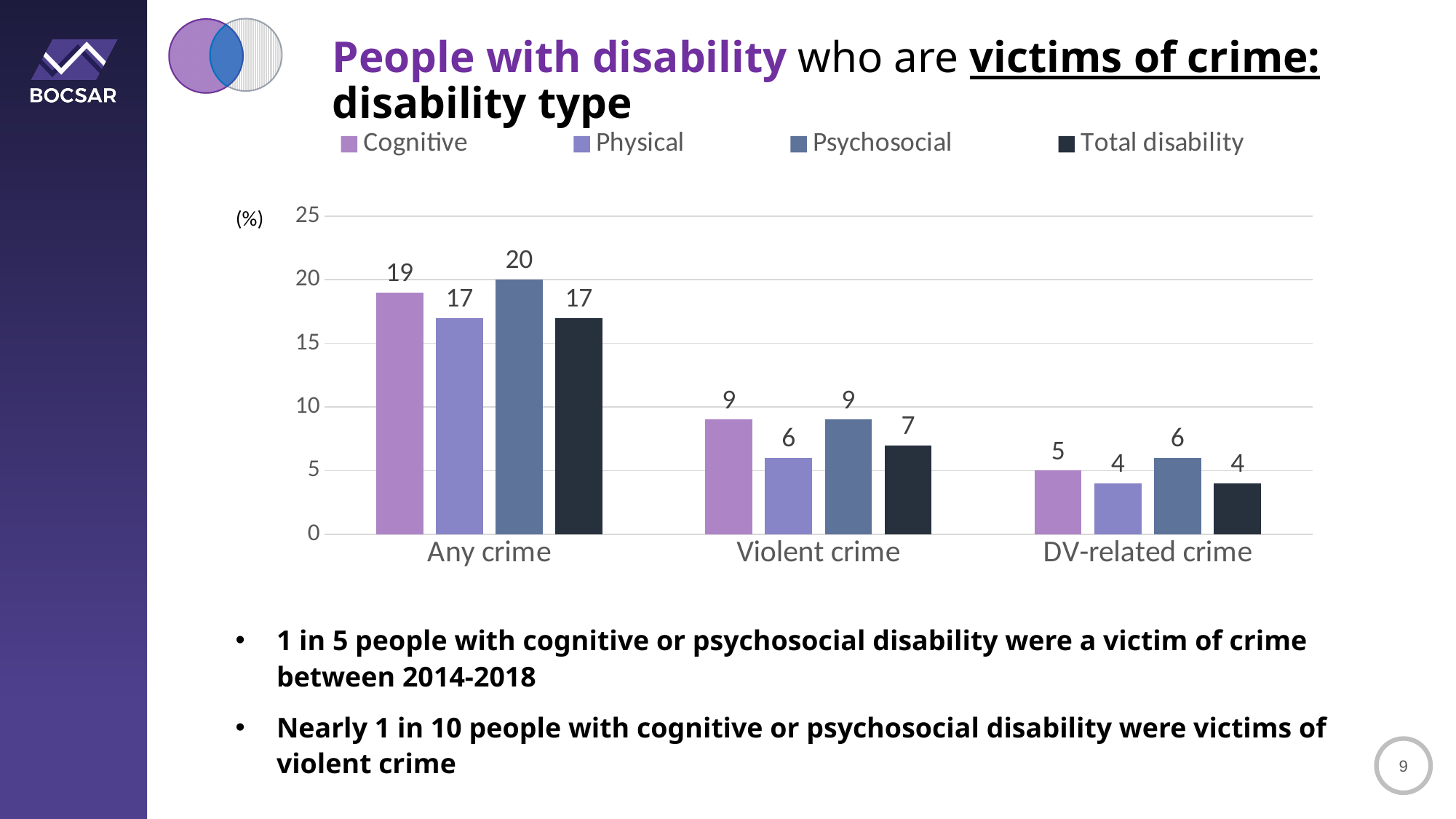
How many series does the legend list? 4 What is the value for Psychosocial disability in the Any crime category? 20 How many crime categories are shown on the x axis? 3 What is the difference between the Cognitive and Physical values in the Any crime category? 2 What is the value for Physical disability in the Violent crime category? 6 What is the value for Total disability in the DV-related crime category? 4 Which disability type has the lowest value in the Violent crime category? Physical What unit is shown on the y axis of the chart? (%) Which is larger in the DV-related crime category: Cognitive or Psychosocial? Psychosocial What kind of chart is shown on the slide? Bar chart Which disability type has the highest value in the Any crime category? Psychosocial Do the Total disability values rise or fall from Any crime to DV-related crime? Fall